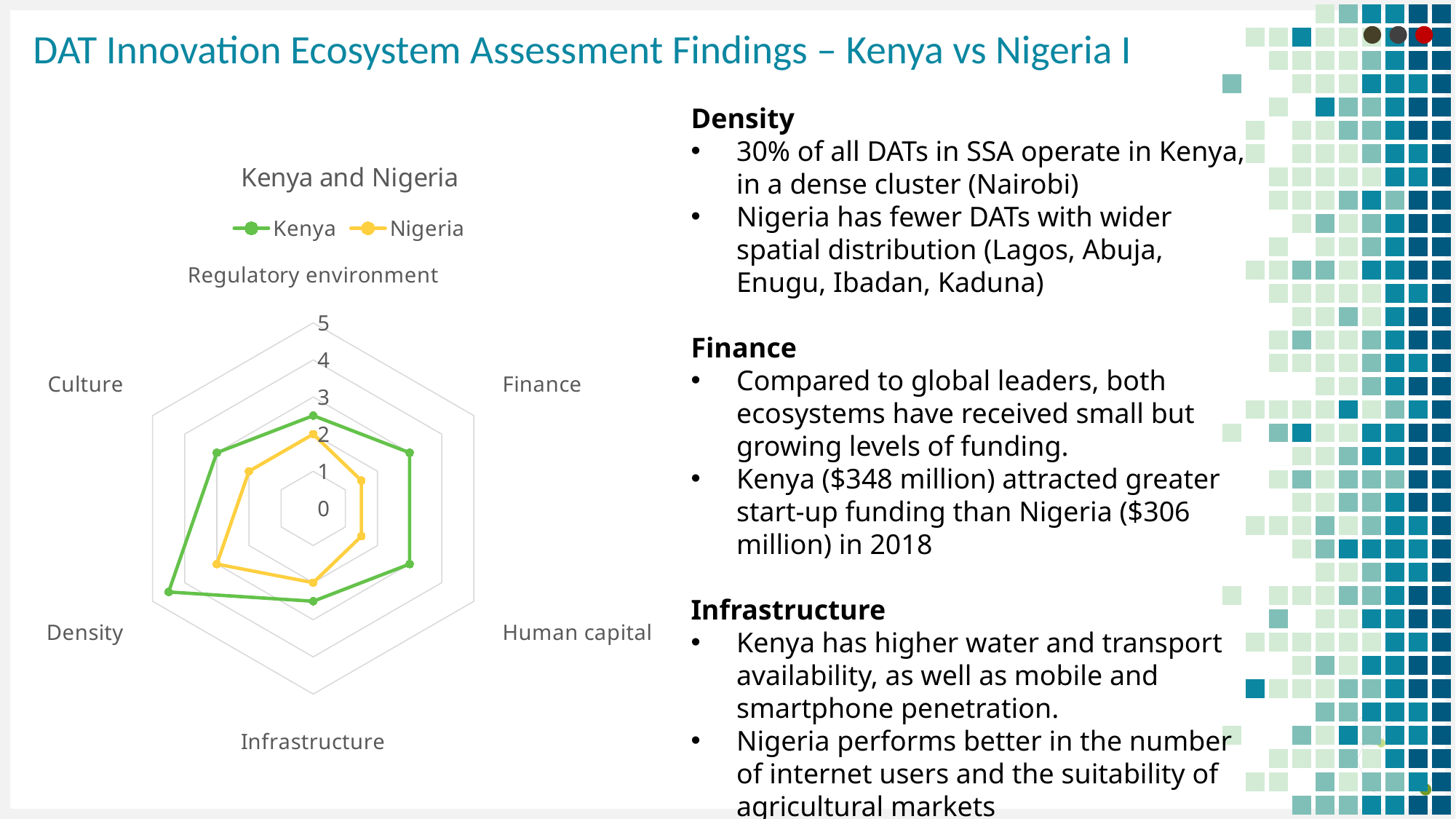
How many categories (axes) does the radar chart have? 6 Which country has the larger value for Finance, Kenya or Nigeria? Kenya For which category does Nigeria have its highest value? Density How many series does the chart's legend list? 2 Which colour represents Nigeria in the chart? Yellow For which category does Kenya have its highest value? Density Is Kenya's value for Density greater or less than 3? greater Is Kenya's value for Culture greater or less than 2? greater What is the title of the chart? Kenya and Nigeria Which country has the larger value for Density, Kenya or Nigeria? Kenya What kind of chart is shown on the slide? Radar chart Is Nigeria's value for Finance greater or less than 2? less